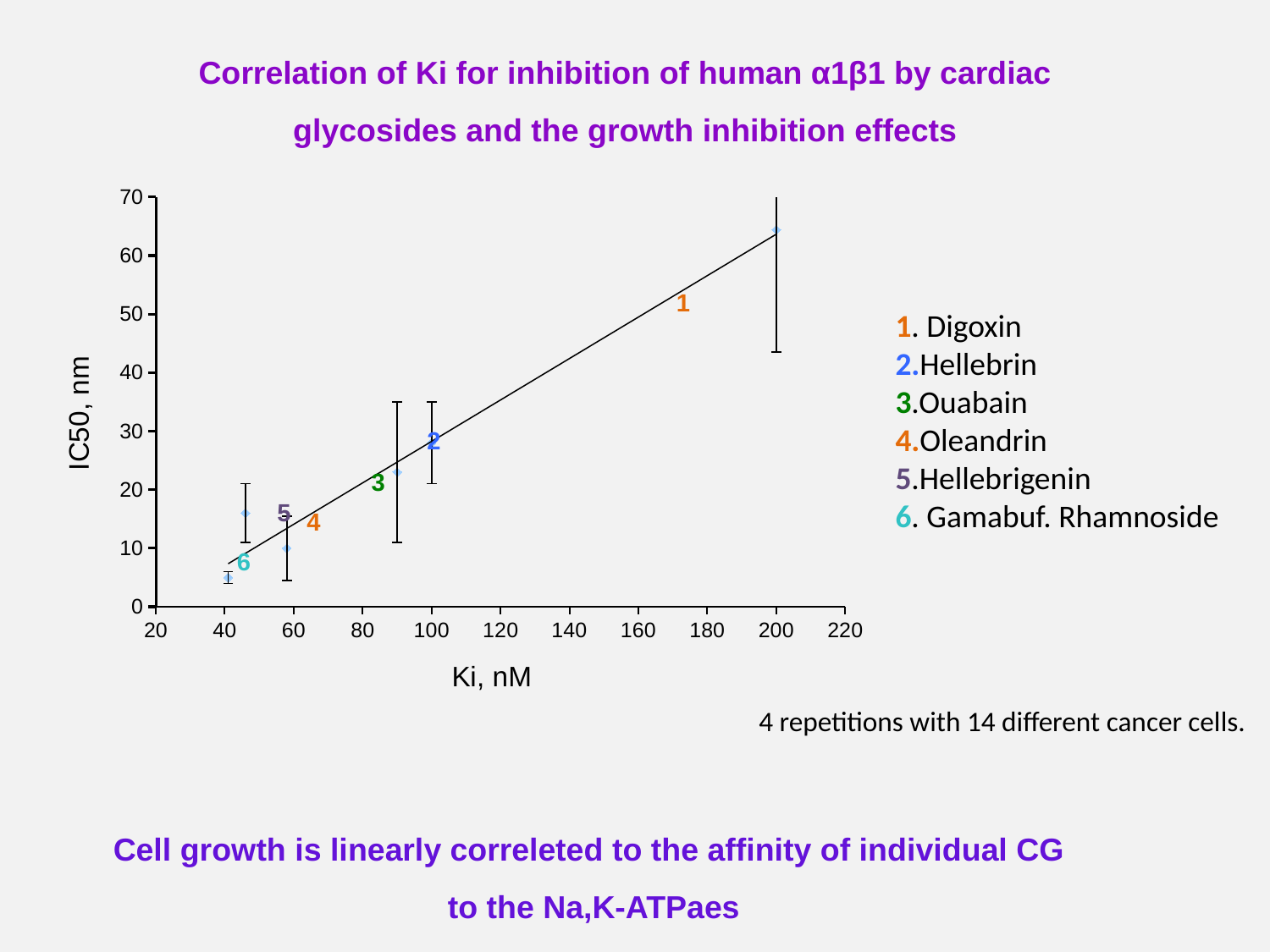
What is the label of the y axis of the chart? IC50, nm Is the IC50 value for Ouabain greater or less than 40? less Is the IC50 value for Digoxin greater or less than 60? greater Which compound has the highest Ki value in the chart? Digoxin Is the Ki value for Hellebrin greater or less than 80? greater Which compound has the highest IC50 value in the chart? Digoxin How many cardiac glycosides are listed in the legend of the chart? 6 Does IC50 rise or fall as Ki increases along the x axis? Rises What is the label of the x axis of the chart? Ki, nM What kind of chart is shown on the slide? Scatter plot with a trend line Which has the larger IC50 value, Digoxin or Hellebrin? Digoxin